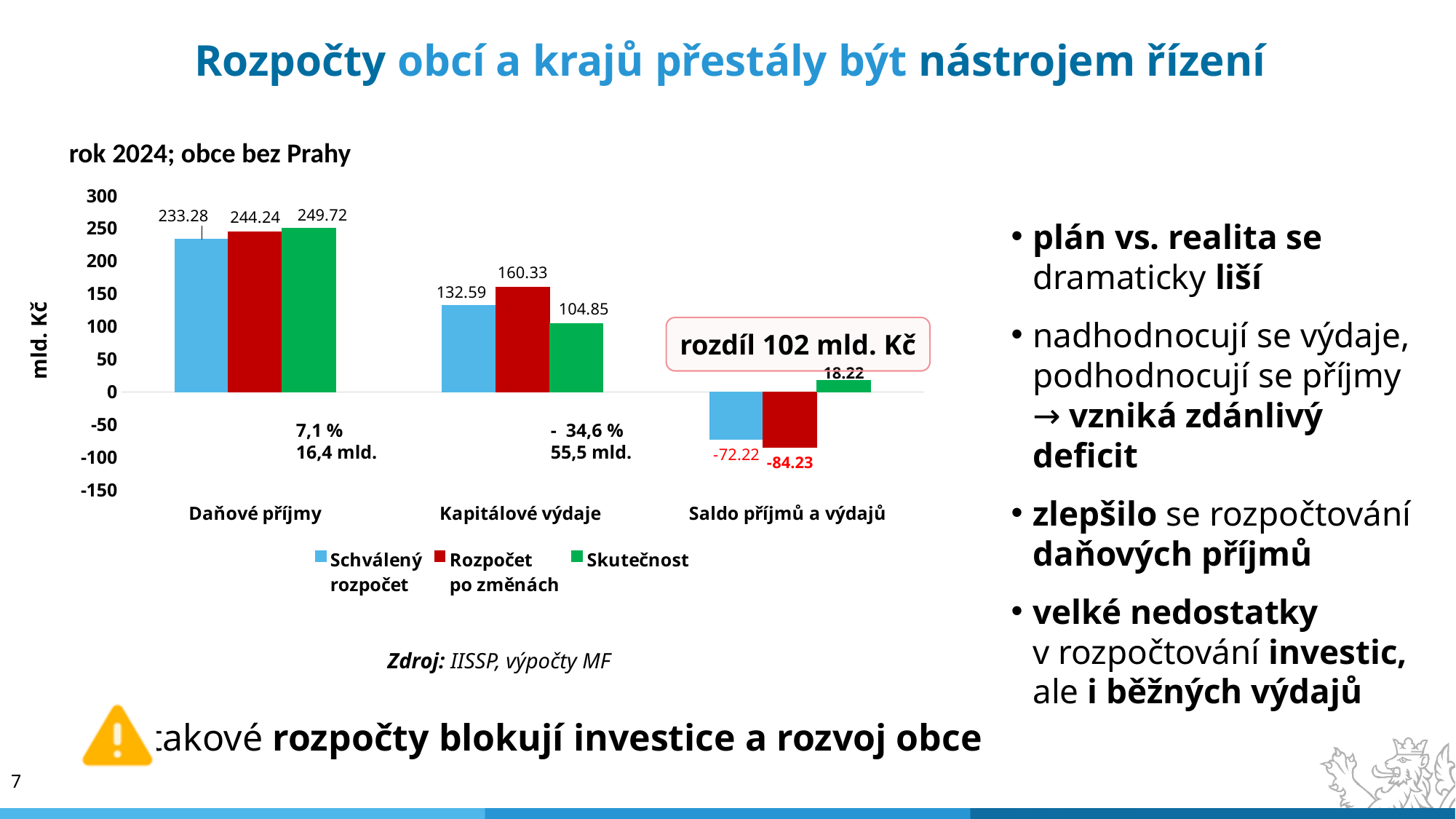
What is the Skutečnost value for Daňové příjmy? 249.72 What is the Schválený rozpočet value for Saldo příjmů a výdajů? -72.22 What unit is shown on the vertical axis of the chart? mld. Kč What kind of chart is shown on the slide? bar chart What is the Rozpočet po změnách value for Kapitálové výdaje? 160.33 Is the Skutečnost value for Saldo příjmů a výdajů greater or less than 0? greater What is the difference between the Rozpočet po změnách and Skutečnost values for Kapitálové výdaje? 55.48 How many categories are shown on the x axis of the chart? 3 Which series has the lowest value for Saldo příjmů a výdajů? Rozpočet po změnách Which is larger for Kapitálové výdaje: the Schválený rozpočet value or the Skutečnost value? Schválený rozpočet Which series has the highest value for Daňové příjmy? Skutečnost How many series does the chart legend list? 3